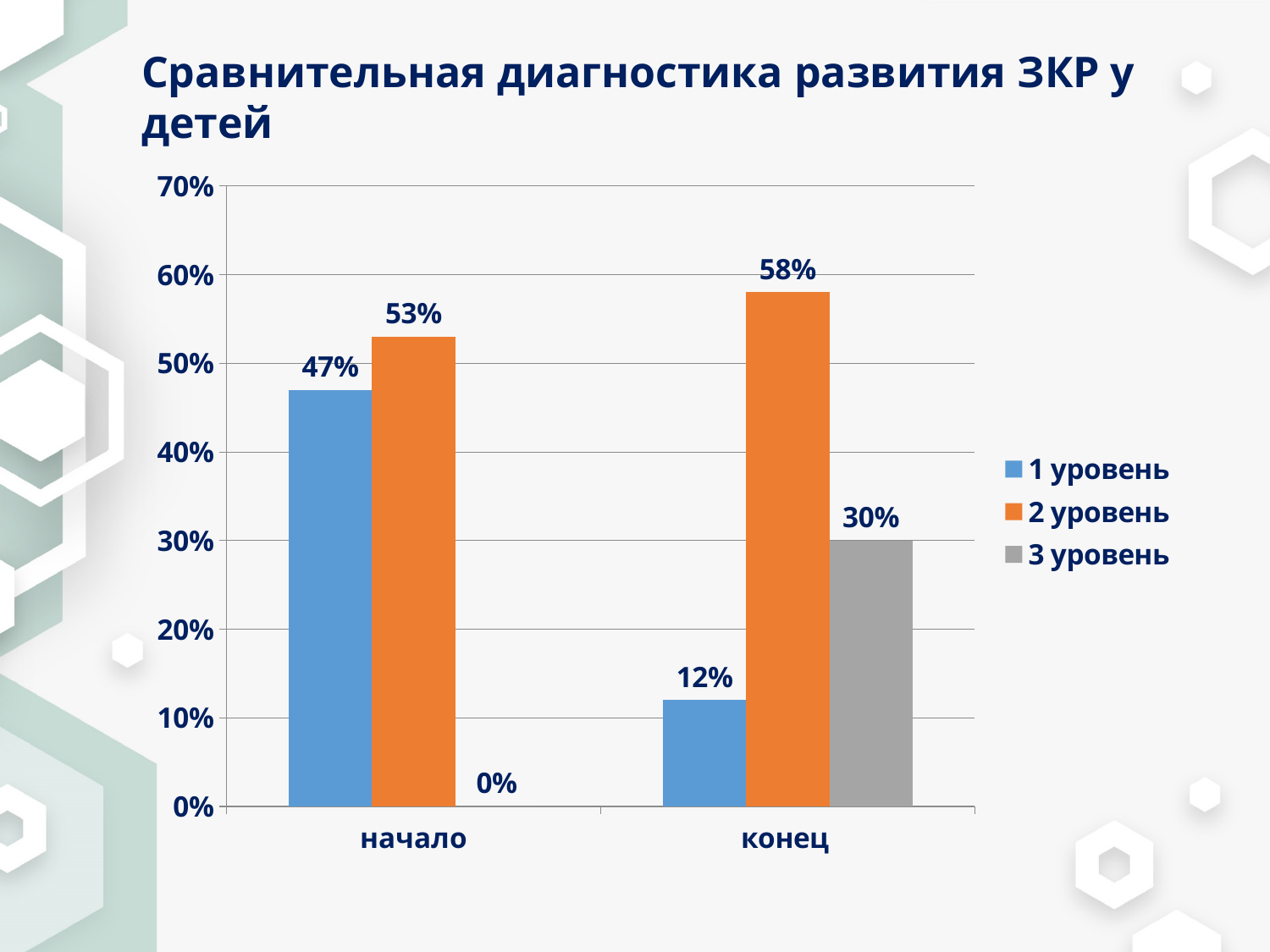
Which series has the highest value at "конец"? 2 уровень Which series has the lowest value at "начало"? 3 уровень What is the value for "1 уровень" at "конец"? 12% What is the value for "3 уровень" at "начало"? 0% What is the difference between the "2 уровень" values at "конец" and "начало"? 5% What kind of chart is shown on the slide? Bar chart How many categories are shown on the x axis? 2 What is the value for "2 уровень" at "конец"? 58% Which is larger: "1 уровень" at "начало" or "3 уровень" at "конец"? 1 уровень at начало What is the value for "1 уровень" at "начало"? 47% What is the title of the chart on the slide? Сравнительная диагностика развития ЗКР у детей How many series does the legend list? 3